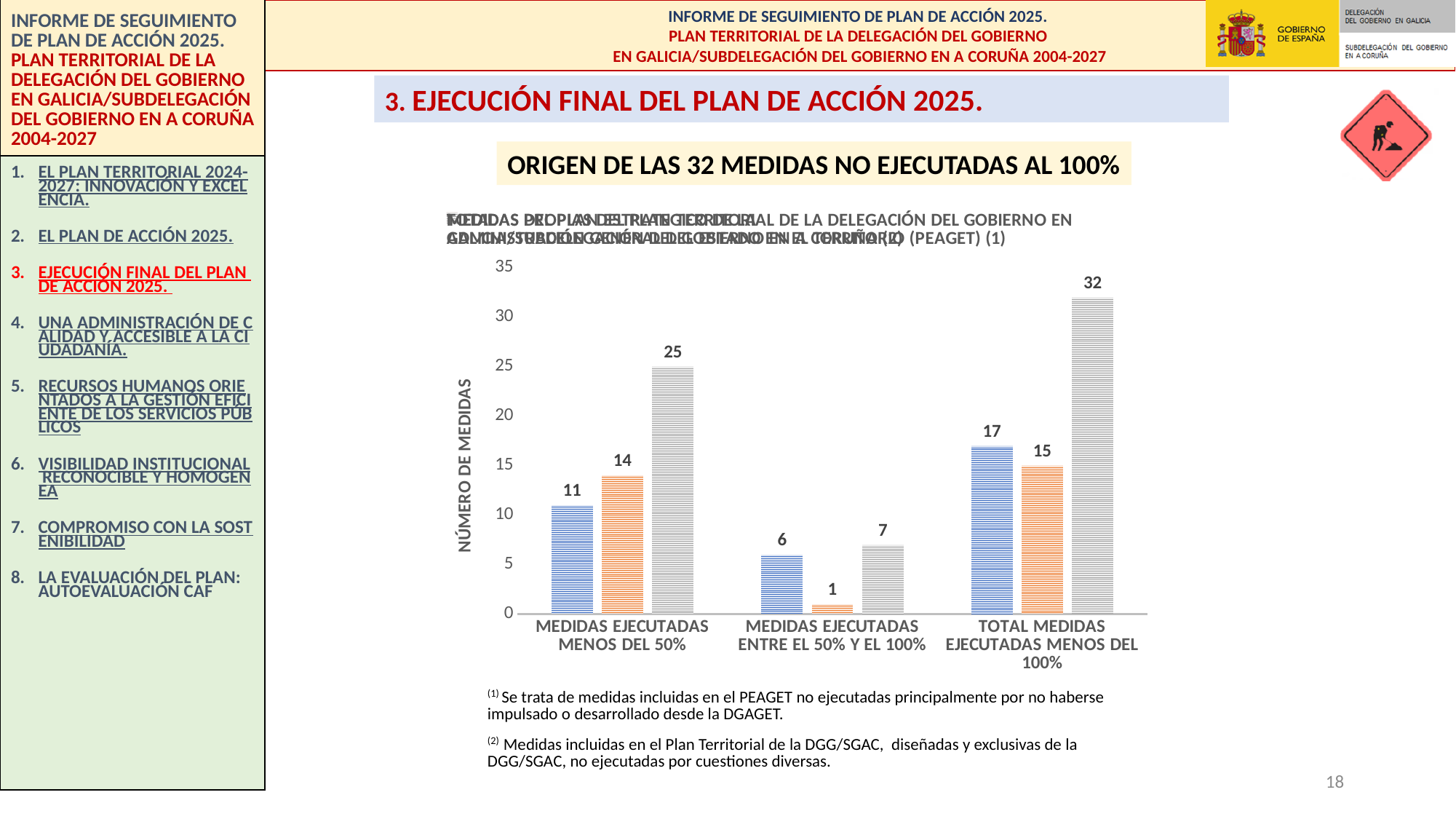
How many categories are shown on the x axis of the chart? 3 What is the value of the grey bar for 'MEDIDAS EJECUTADAS MENOS DEL 50%'? 25 What is the label of the vertical axis of the chart? NÚMERO DE MEDIDAS What is the value of the blue bar for 'MEDIDAS EJECUTADAS MENOS DEL 50%'? 11 What is the difference between the blue bar and the orange bar for 'MEDIDAS EJECUTADAS MENOS DEL 50%'? 3 Which category has the lowest orange bar? MEDIDAS EJECUTADAS ENTRE EL 50% Y EL 100% What is the value of the orange bar for 'MEDIDAS EJECUTADAS ENTRE EL 50% Y EL 100%'? 1 For 'TOTAL MEDIDAS EJECUTADAS MENOS DEL 100%', which is larger, the blue bar or the orange bar? The blue bar Which category has the highest grey bar? TOTAL MEDIDAS EJECUTADAS MENOS DEL 100% What type of chart is shown on the slide? Bar chart What is the value of the grey bar for 'TOTAL MEDIDAS EJECUTADAS MENOS DEL 100%'? 32 What is the difference between the grey bars for 'TOTAL MEDIDAS EJECUTADAS MENOS DEL 100%' and 'MEDIDAS EJECUTADAS MENOS DEL 50%'? 7